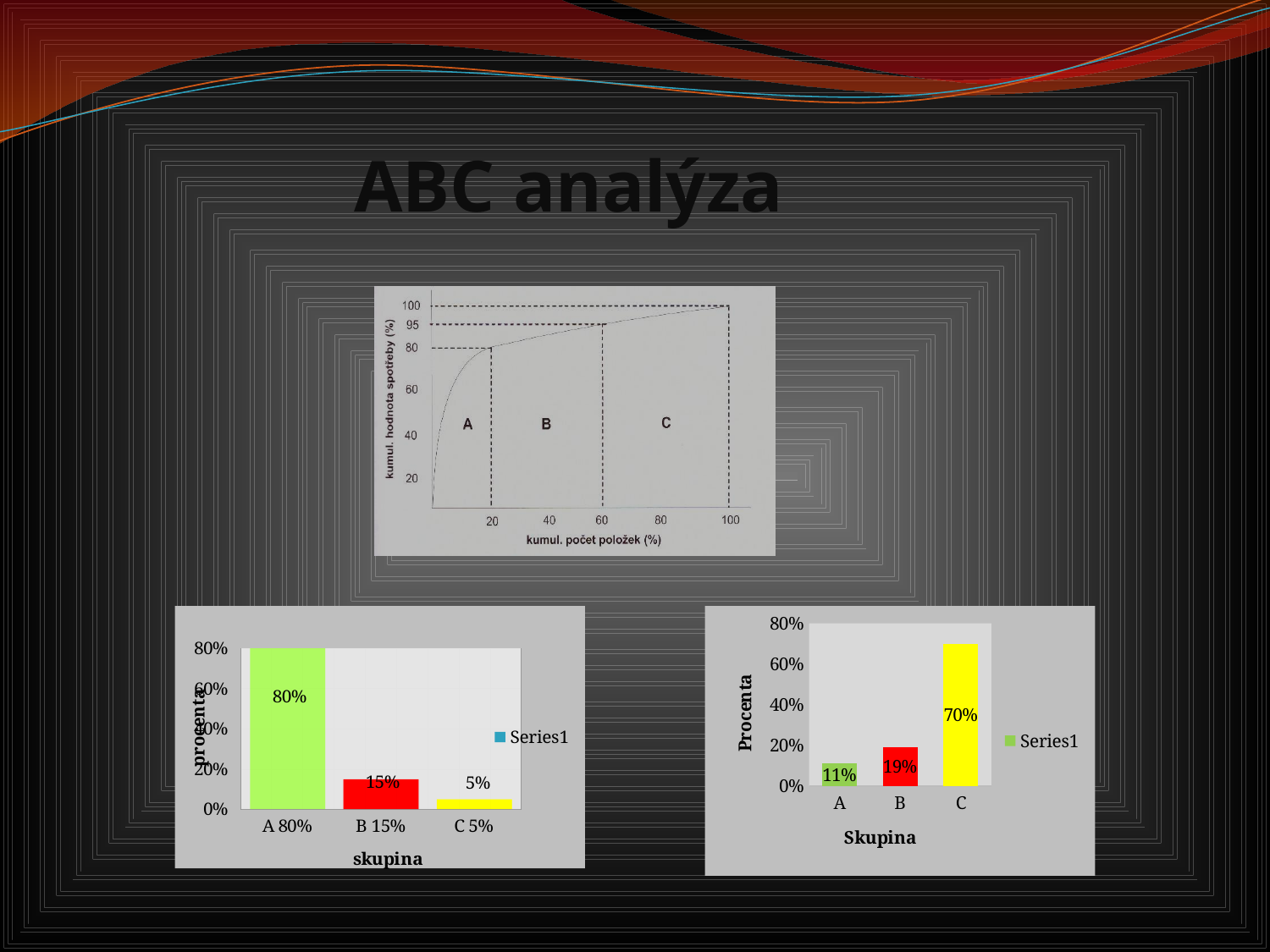
In the bottom-left bar chart, which category has the lowest value? C 5% What is the x-axis title of the bottom-right bar chart? Skupina In the bottom-left bar chart, what is the value for category A 80%? 80% In the bottom-right bar chart, what is the difference between the values for C and A? 59% How many categories are shown in the bottom-right bar chart? 3 In the bottom-left bar chart, what is the difference between the values for A 80% and B 15%? 65% In the bottom-right bar chart, what is the value for group C? 70% In the bottom-right bar chart, which is larger, the value for A or the value for B? B In the bottom-left bar chart, what is the value for category C 5%? 5% In the bottom-right bar chart, which group has the highest value? C In the bottom-right bar chart, what is the value for group B? 19% What kind of chart is the bottom-left chart? bar chart